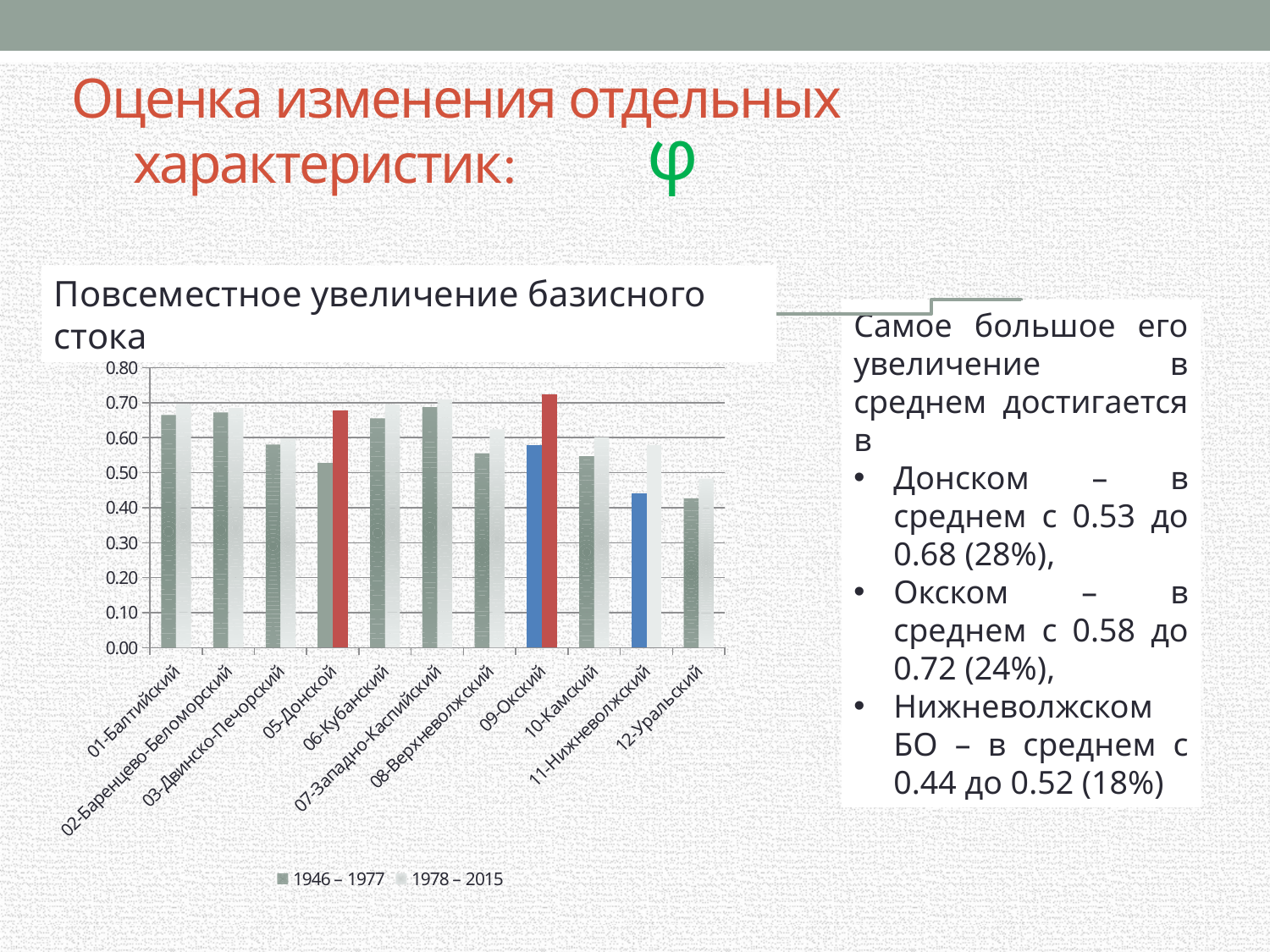
For 05-Донской, which series has the larger value: 1946 – 1977 or 1978 – 2015? 1978 – 2015 Is the 1978 – 2015 value for 08-Верхневолжский greater or less than 0.50? greater How many categories (basins) are shown on the x axis of the chart? 11 Which two categories have their 1978 – 2015 bars highlighted in red? 05-Донской and 09-Окский Which has the larger 1946 – 1977 value: 01-Балтийский or 12-Уральский? 01-Балтийский How many series does the chart legend list? 2 Is the 1946 – 1977 value for 05-Донской greater or less than 0.60? less What kind of chart is shown on the slide? bar chart Is the 1946 – 1977 value for 11-Нижневолжский greater or less than 0.50? less What are the two series named in the chart legend? 1946 – 1977 and 1978 – 2015 Which category has the lowest 1978 – 2015 value? 12-Уральский